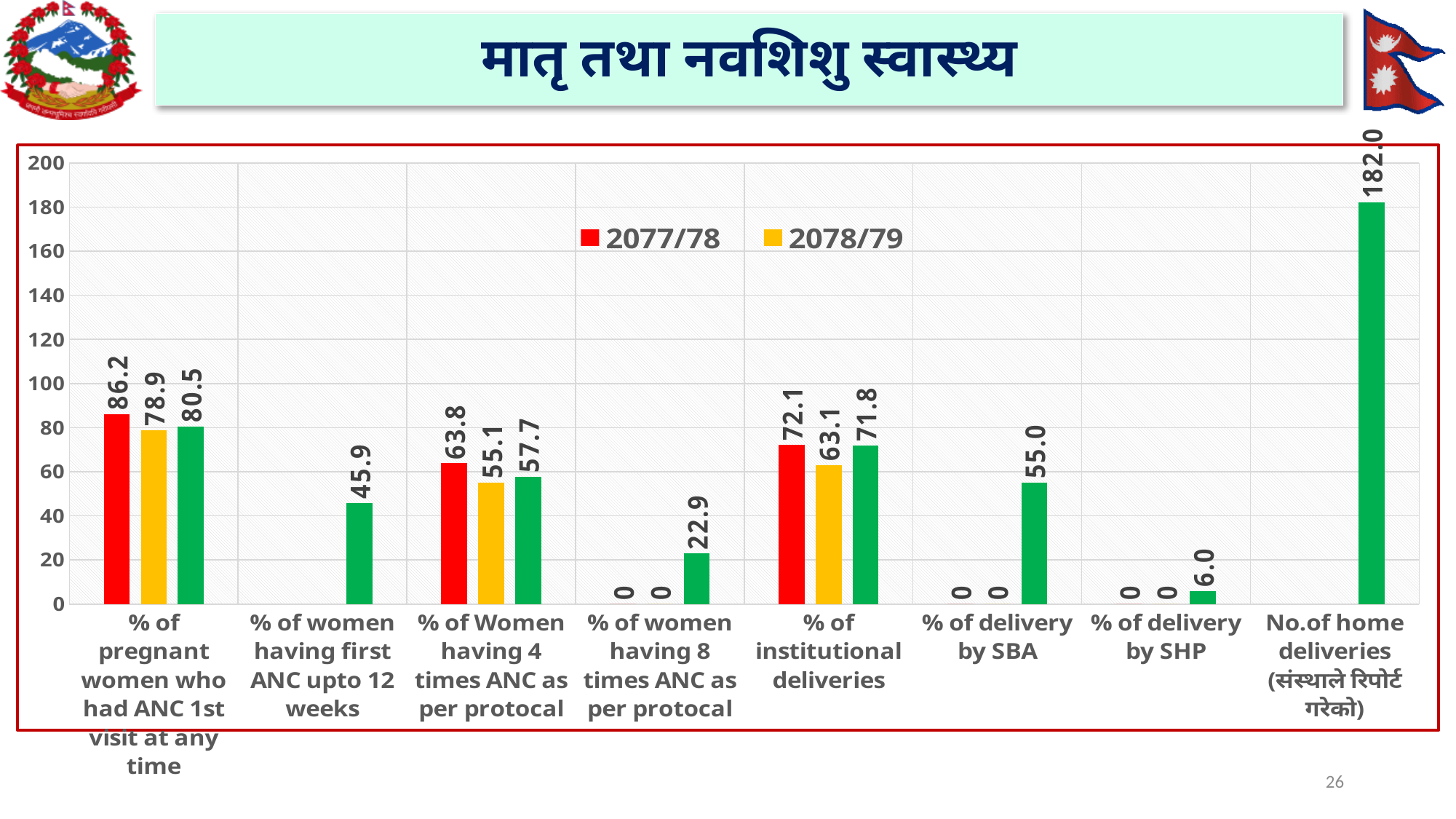
What is the 2077/78 value for % of pregnant women who had ANC 1st visit at any time? 86.2 What is the value shown by the green bar for No.of home deliveries? 182.0 Which is larger for % of Women having 4 times ANC as per protocal: the 2077/78 value or the 2078/79 value? 2077/78 What is the 2078/79 value for % of institutional deliveries? 63.1 Which category has the highest 2077/78 value? % of pregnant women who had ANC 1st visit at any time What colour represents the 2078/79 series in the legend? yellow How many series does the legend list? 2 What is the 2077/78 value for % of delivery by SBA? 0 What is the 2078/79 value for % of Women having 4 times ANC as per protocal? 55.1 What is the difference between the 2077/78 and 2078/79 values for % of institutional deliveries? 9.0 How many categories are shown on the x axis? 8 What kind of chart is shown on the slide? bar chart